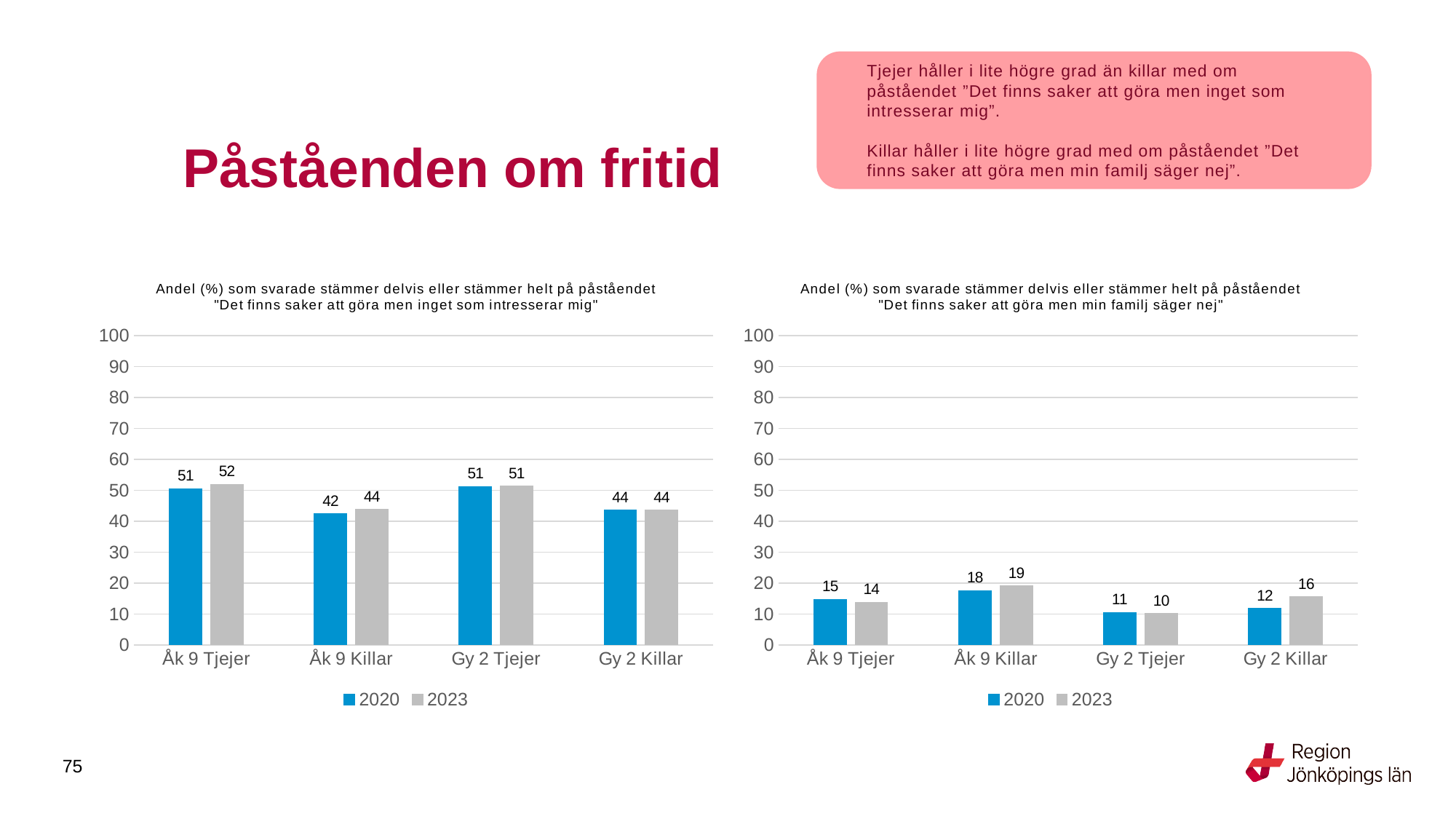
In the left chart ("Det finns saker att göra men inget som intresserar mig"), what is the value for Åk 9 Killar in 2023? 44 In the left chart ("Det finns saker att göra men inget som intresserar mig"), what is the value for Gy 2 Tjejer in 2020? 51 How many series does the legend of the right chart list? 2 In the right chart ("Det finns saker att göra men min familj säger nej"), what is the value for Gy 2 Killar in 2023? 16 In the left chart ("Det finns saker att göra men inget som intresserar mig"), which category has the lowest 2020 value? Åk 9 Killar In the right chart ("Det finns saker att göra men min familj säger nej"), which category has the lowest 2020 value? Gy 2 Tjejer In the right chart ("Det finns saker att göra men min familj säger nej"), what is the difference between the 2020 and 2023 values for Gy 2 Killar? 4 In the right chart ("Det finns saker att göra men min familj säger nej"), which is larger: the 2020 value for Åk 9 Tjejer or the 2020 value for Gy 2 Tjejer? Åk 9 Tjejer (2020) In the right chart ("Det finns saker att göra men min familj säger nej"), which category has the highest 2023 value? Åk 9 Killar What kind of chart is the left chart? Bar chart In the left chart ("Det finns saker att göra men inget som intresserar mig"), what is the difference between the 2023 values for Åk 9 Tjejer and Åk 9 Killar? 8 How many categories are shown on the x axis of the left chart? 4